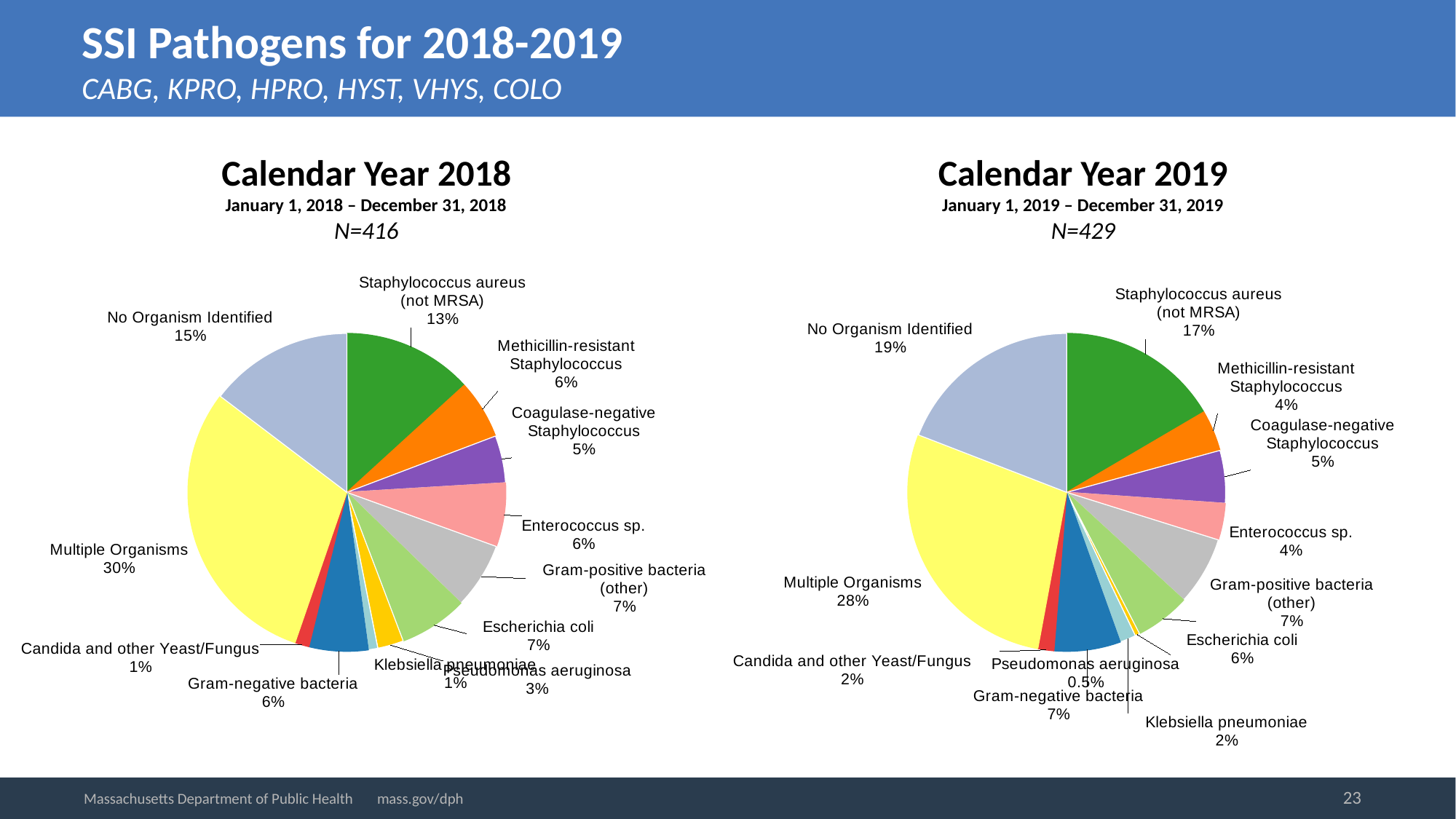
What kind of chart is used for Calendar Year 2018? pie chart In the Calendar Year 2018 chart, what is the difference between the Multiple Organisms share and the No Organism Identified share? 15% What date range is shown under the Calendar Year 2018 chart title? January 1, 2018 – December 31, 2018 In the Calendar Year 2019 chart, what share is Staphylococcus aureus (not MRSA)? 17% How many slices does the Calendar Year 2019 pie chart have? 12 In the Calendar Year 2018 chart, which category has the largest slice? Multiple Organisms In the Calendar Year 2018 chart, what share is Multiple Organisms? 30% In the Calendar Year 2019 chart, what share is No Organism Identified? 19% What is the N value shown for the Calendar Year 2019 chart? N=429 In the Calendar Year 2019 chart, which category has the smallest slice? Pseudomonas aeruginosa In the Calendar Year 2019 chart, which is larger: Methicillin-resistant Staphylococcus or Coagulase-negative Staphylococcus? Coagulase-negative Staphylococcus